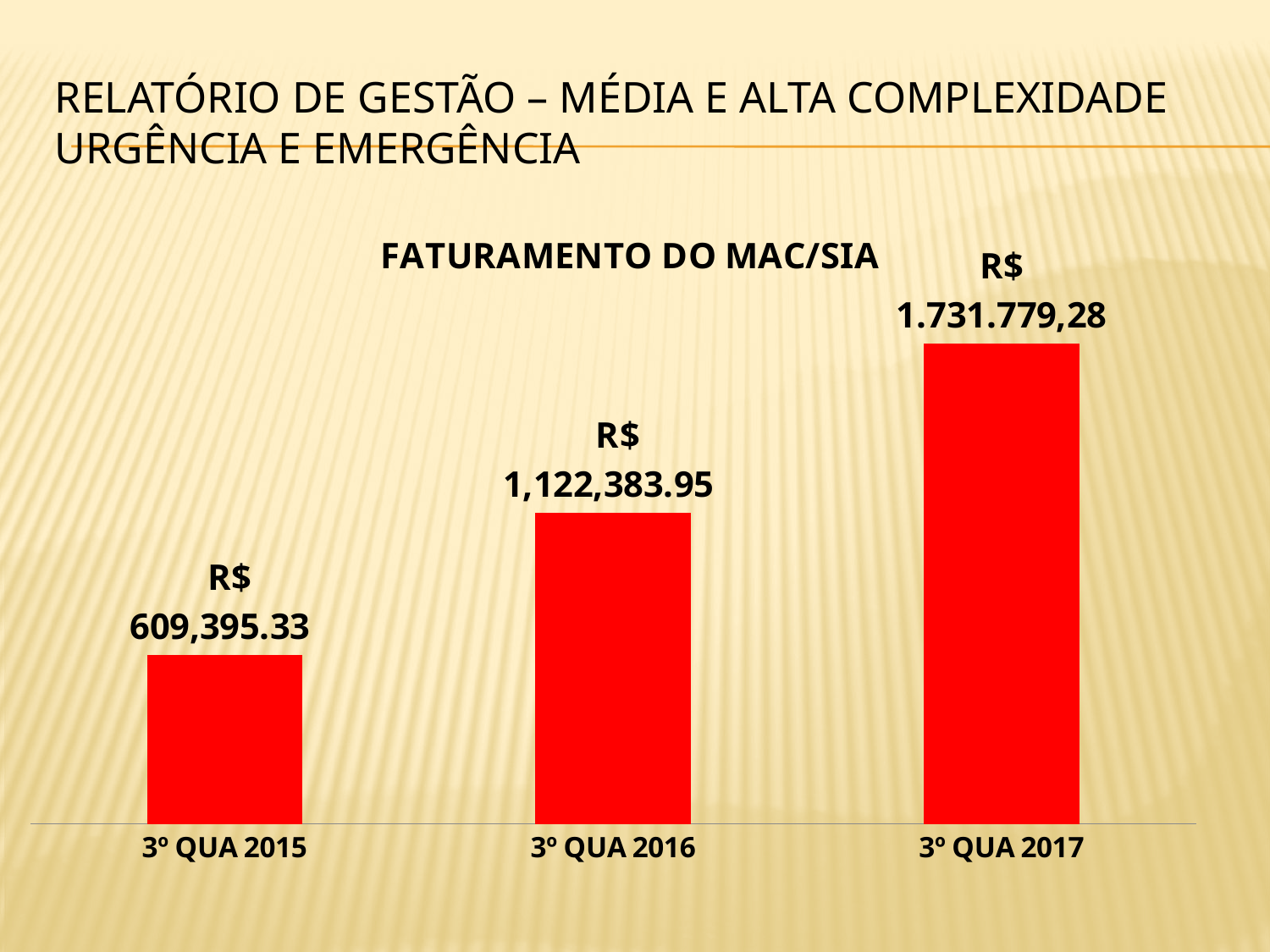
What is the value for 3º QUA 2015? R$ 609,395.33 What kind of chart is shown on the slide? Bar chart Which is larger, the value for 3º QUA 2016 or the value for 3º QUA 2015? 3º QUA 2016 What colour are the bars in the chart? Red Which category has the lowest value? 3º QUA 2015 What is the title of the chart? FATURAMENTO DO MAC/SIA What is the difference between the values for 3º QUA 2016 and 3º QUA 2015? R$ 512,988.62 Which category has the highest value? 3º QUA 2017 What is the value for 3º QUA 2017? R$ 1.731.779,28 Do the values rise or fall from 3º QUA 2015 to 3º QUA 2017? Rise What is the value for 3º QUA 2016? R$ 1,122,383.95 How many categories are shown in the chart? 3